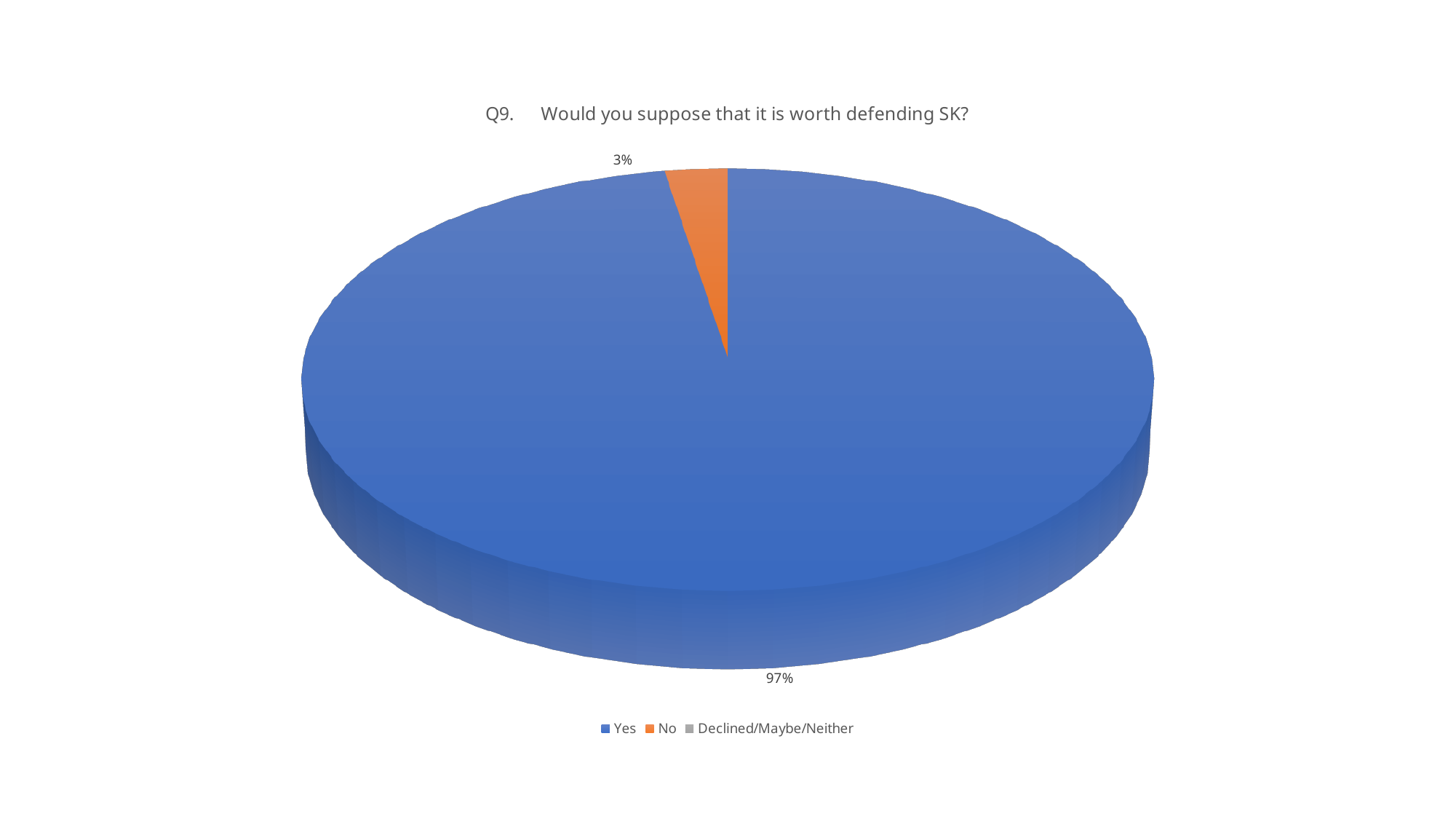
What share of the pie does the "Yes" slice represent? 97% What kind of chart is shown on the slide? Pie chart Which category has the largest slice of the pie? Yes What is the difference in percentage points between the "Yes" and "No" slices? 94 What share of the pie does the "No" slice represent? 3% What is the title of the chart? Q9. Would you suppose that it is worth defending SK? Which of the two labelled slices is larger, "Yes" or "No"? Yes How many entries does the legend list? 3 What colour is the "No" slice? Orange Is the share for "Yes" greater or less than 50%? greater